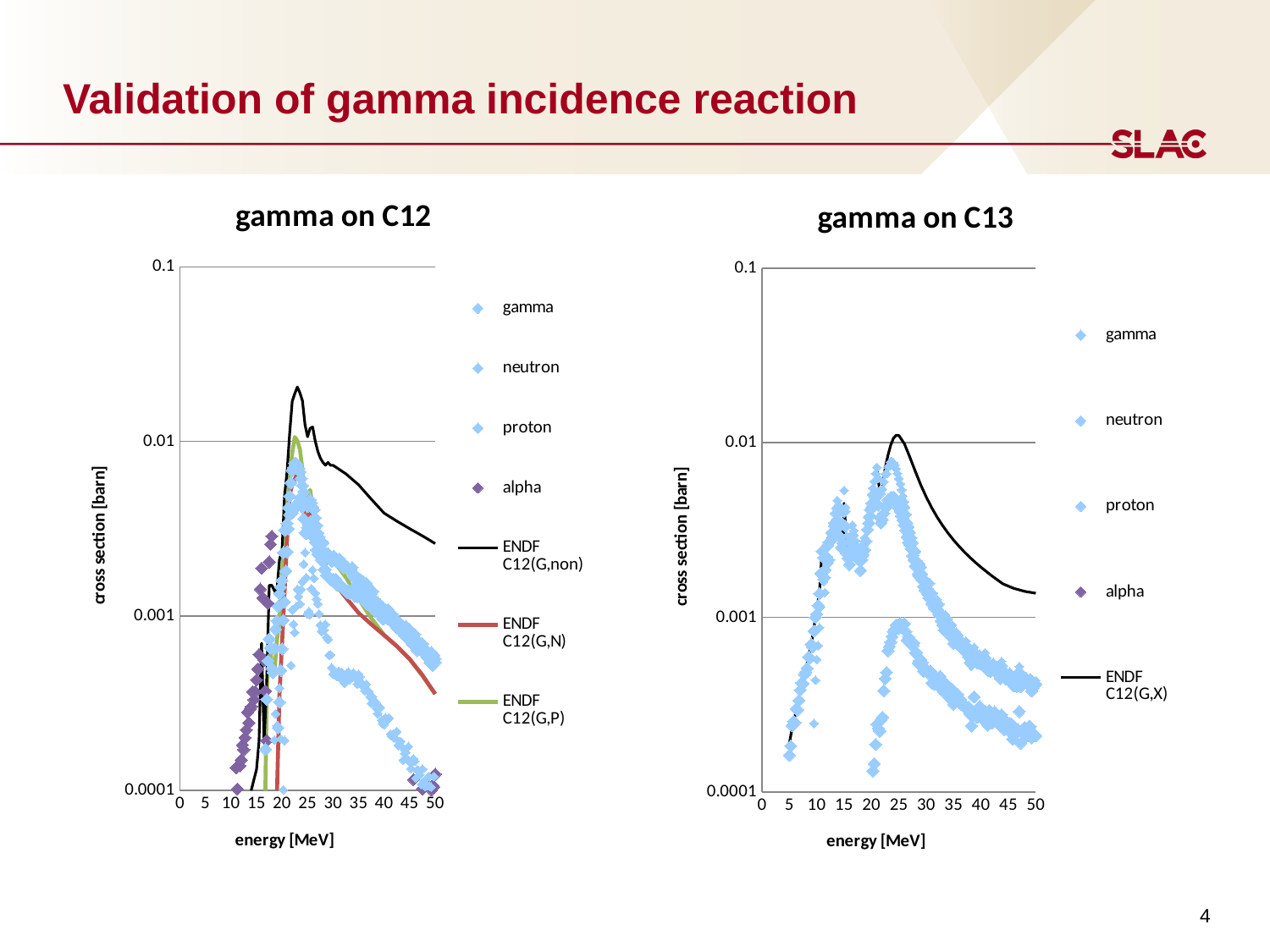
In the 'gamma on C12' chart, is the peak value of the ENDF C12(G,non) line greater or less than 0.01? greater In the 'gamma on C13' chart, is the value of the ENDF C12(G,X) line at 50 MeV greater or less than 0.001? greater In the 'gamma on C13' chart, does the ENDF C12(G,X) line rise or fall between 25 MeV and 50 MeV? fall What is the maximum value shown on the x axis of the 'gamma on C12' chart? 50 In the 'gamma on C12' chart, does the ENDF C12(G,non) line rise or fall between 30 MeV and 50 MeV? fall In the 'gamma on C13' chart, how many series does the legend list? 5 What is the y-axis label of the 'gamma on C12' chart? cross section [barn] What kind of chart is the 'gamma on C12' chart? scatter chart with line series What is the x-axis label of the 'gamma on C13' chart? energy [MeV] In the 'gamma on C12' chart, how many series does the legend list? 7